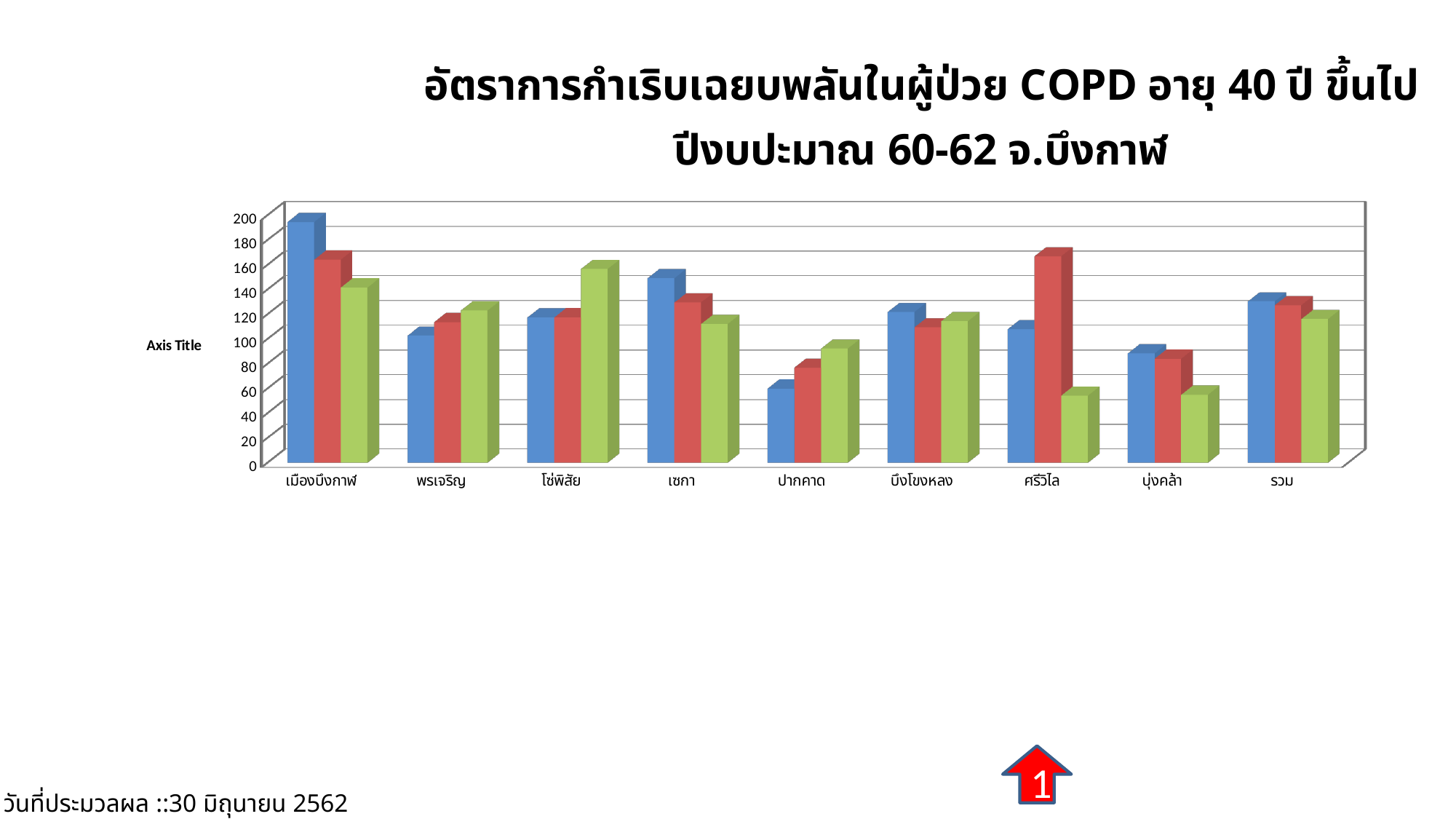
What kind of chart is shown on the slide? bar chart Which category has the tallest blue bar? เมืองบึงกาฬ Which category has the shortest blue bar? ปากคาด Which category has the tallest green bar? โซ่พิสัย What is the label shown on the vertical axis of the chart? Axis Title For โซ่พิสัย, which is larger: the blue bar or the green bar? the green bar Is the blue bar for เมืองบึงกาฬ greater or less than 180? greater Which category has the shortest red bar? ปากคาด How many categories are shown along the x axis of the chart? 9 Is the blue bar for ปากคาด greater or less than 80? less